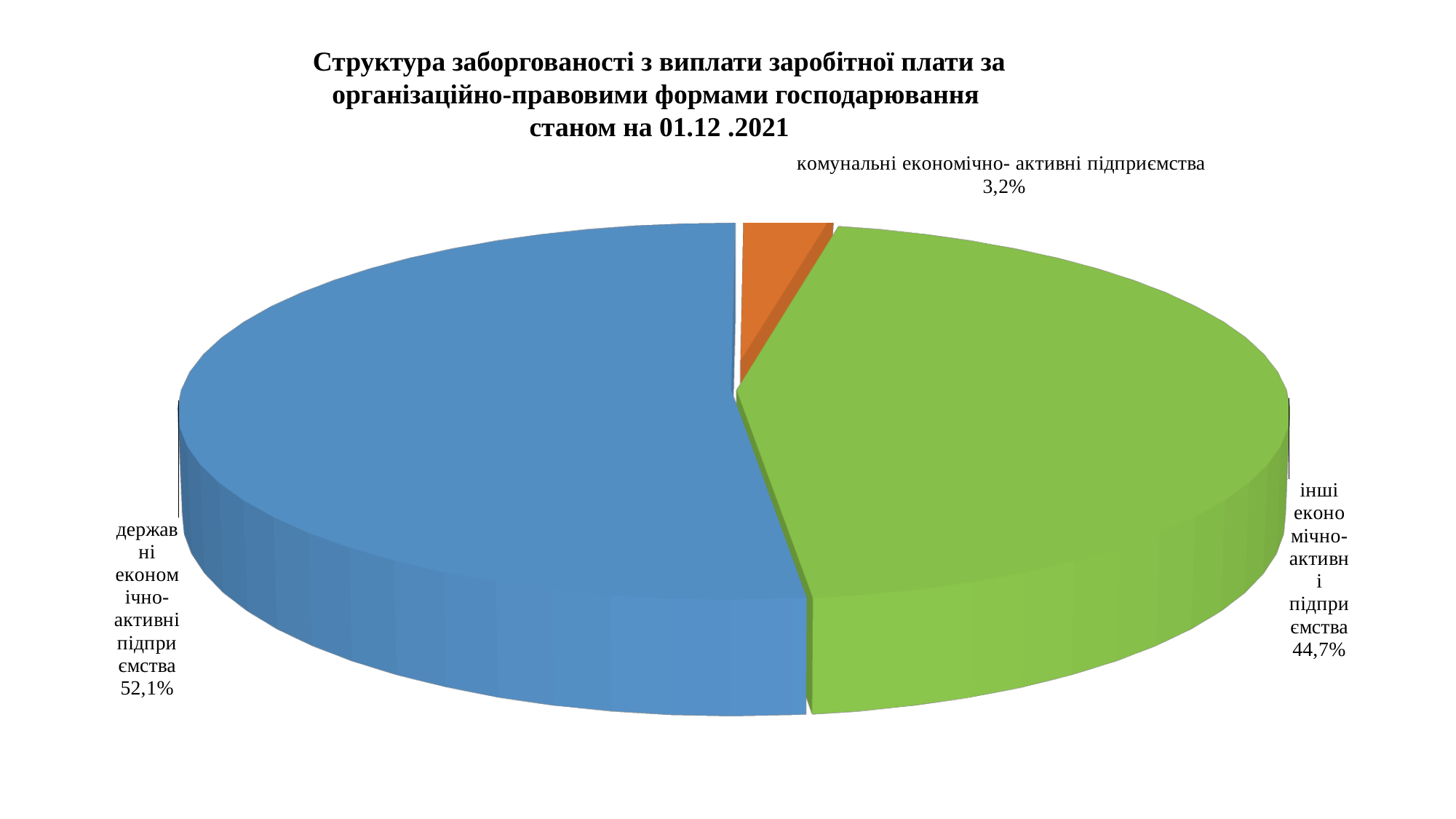
What share of the pie is labelled for комунальні економічно-активні підприємства? 3,2% Which category has the largest slice of the pie? державні економічно-активні підприємства Which slice is larger: державні економічно-активні підприємства or інші економічно-активні підприємства? державні економічно-активні підприємства What share of the pie is labelled for державні економічно-активні підприємства? 52,1% What is the difference in percentage points between the державні and інші економічно-активні підприємства slices? 7,4 What colour is the slice for комунальні економічно-активні підприємства? orange Which category has the smallest slice of the pie? комунальні економічно-активні підприємства What is the difference in percentage points between the інші and комунальні економічно-активні підприємства slices? 41,5 What kind of chart is shown on the slide? pie chart What share of the pie is labelled for інші економічно-активні підприємства? 44,7% How many slices does the pie chart have? 3 As of what date does the chart title say the data is given? 01.12.2021